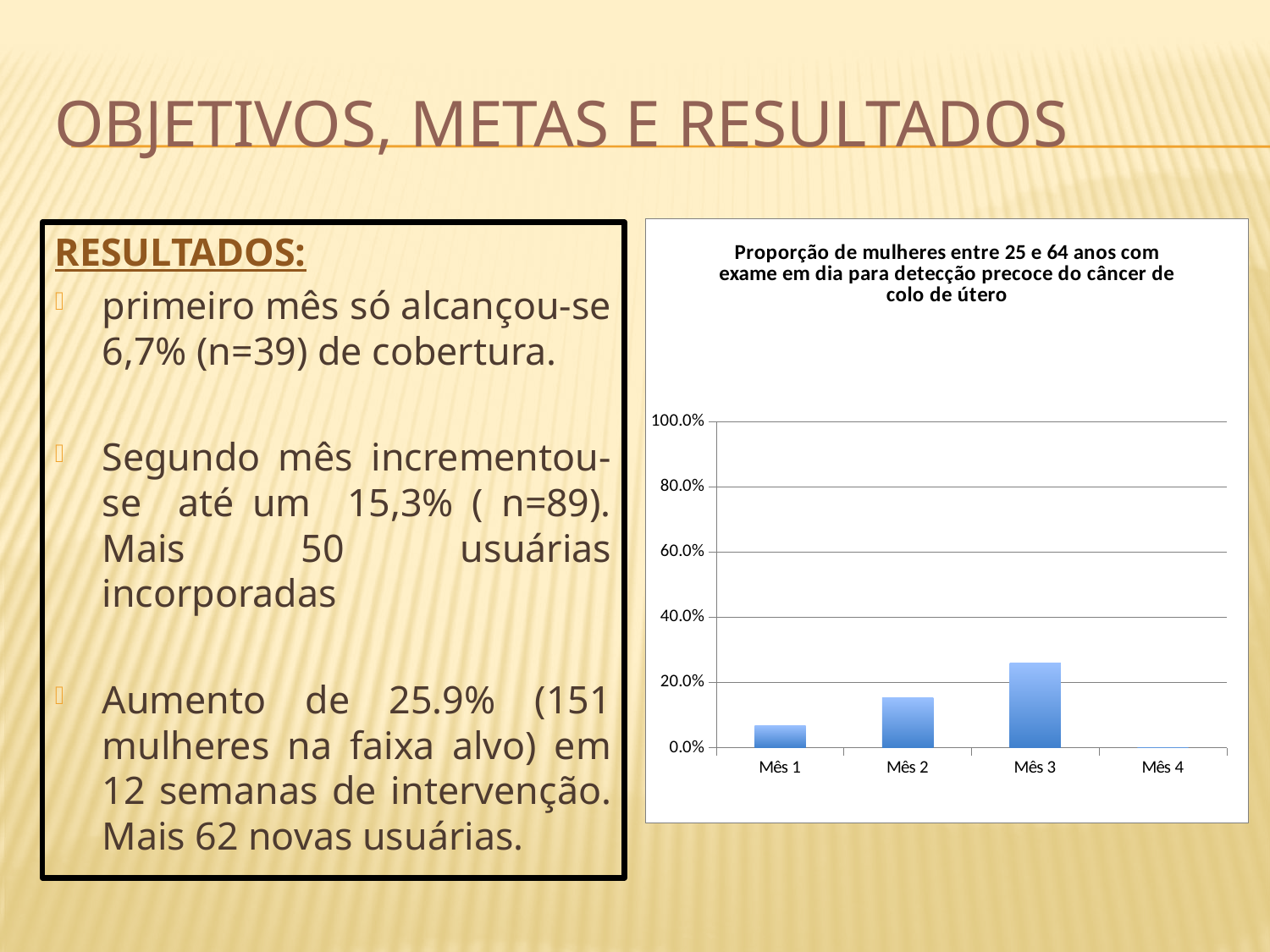
Is the value for Mês 1 greater or less than 20.0%? less Which is larger, the value for Mês 2 or the value for Mês 1? Mês 2 How many categories are shown on the x axis of the chart? 4 Do the values rise or fall from Mês 1 to Mês 3? rise Which month has the tallest bar in the chart? Mês 3 Is the value for Mês 3 greater or less than 40.0%? less Among the months with a bar plotted, which has the shortest bar? Mês 1 Is the value for Mês 2 greater or less than 20.0%? less What is the title of the chart? Proporção de mulheres entre 25 e 64 anos com exame em dia para detecção precoce do câncer de colo de útero Which month has no bar plotted in the chart? Mês 4 What kind of chart is shown on the slide? bar chart